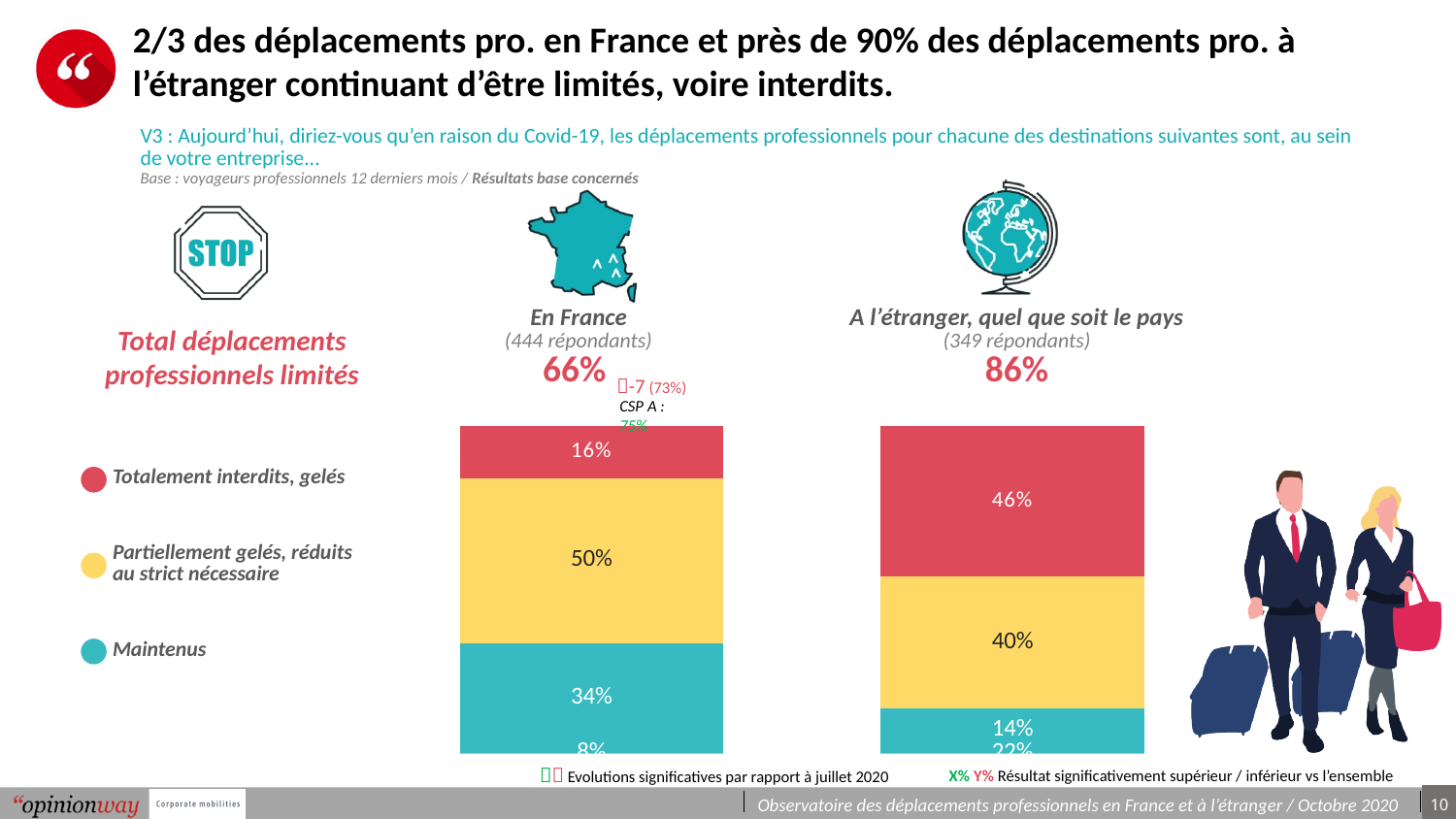
How many categories does the legend on the left list? 3 In the 'En France' chart, what percentage is shown for the red segment (Totalement interdits, gelés)? 16% Which chart shows a larger 'Maintenus' value, 'En France' or 'A l'étranger, quel que soit le pays'? En France What is the difference between the 'Totalement interdits, gelés' value in the 'A l'étranger' chart and the same value in the 'En France' chart? 30% In the 'A l'étranger, quel que soit le pays' chart, what percentage is shown for the yellow segment (Partiellement gelés, réduits au strict nécessaire)? 40% In the 'En France' chart, what percentage is shown for the teal segment (Maintenus)? 34% In the 'En France' chart, which segment has the largest value? Partiellement gelés, réduits au strict nécessaire What type of chart is used to show the 'En France' results? Stacked bar chart In the 'A l'étranger, quel que soit le pays' chart, which segment has the smallest value? Maintenus In the 'A l'étranger, quel que soit le pays' chart, what percentage is shown for the teal segment (Maintenus)? 14% In the 'En France' chart, what percentage is shown for the yellow segment (Partiellement gelés, réduits au strict nécessaire)? 50% In the 'A l'étranger, quel que soit le pays' chart, what percentage is shown for the red segment (Totalement interdits, gelés)? 46%